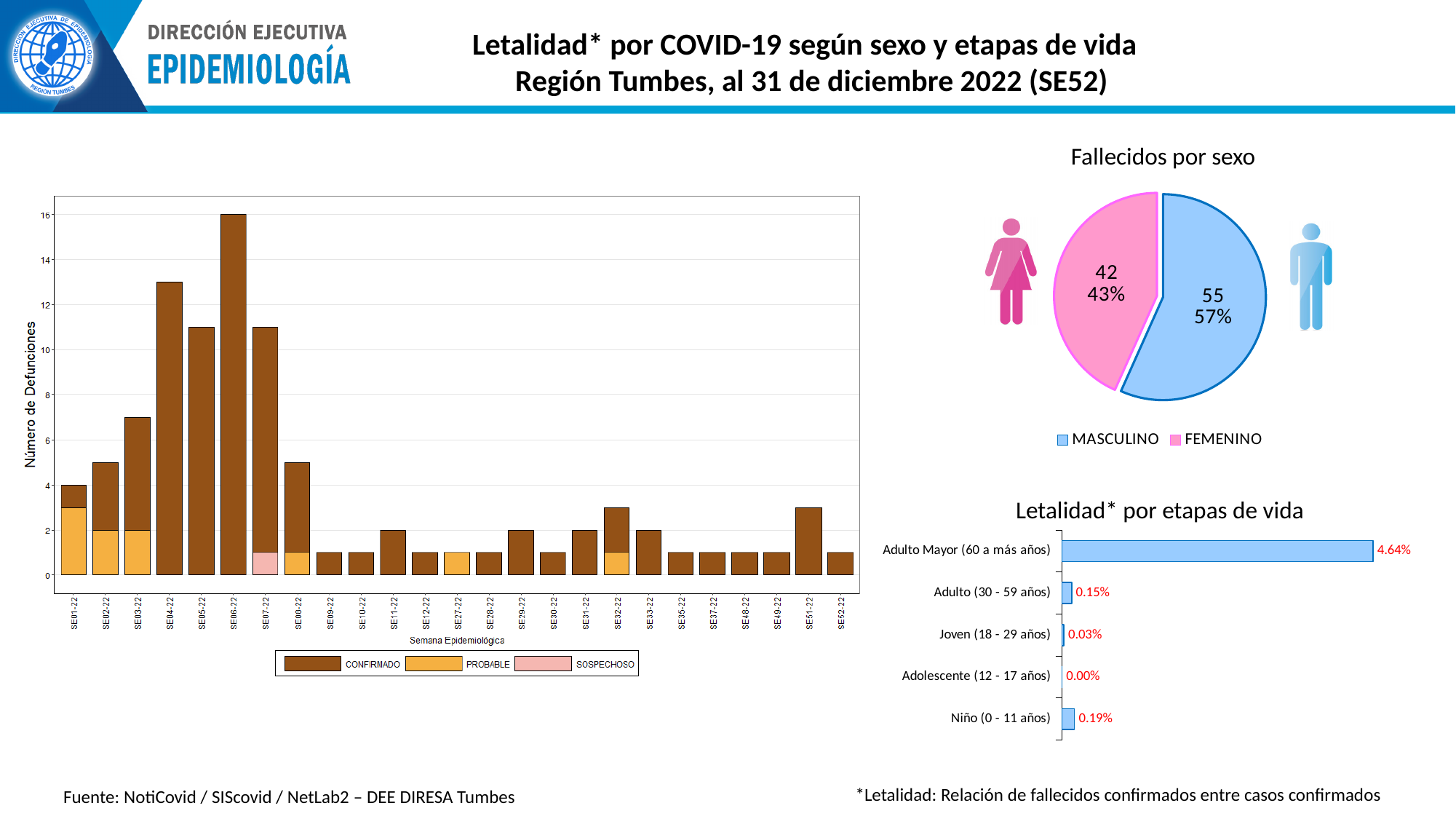
In the 'Letalidad* por etapas de vida' chart, what is the value for Adulto Mayor (60 a más años)? 4.64% How many series does the legend of the weekly 'Número de Defunciones' bar chart list? 3 In the 'Fallecidos por sexo' pie chart, which group has the larger slice, MASCULINO or FEMENINO? MASCULINO In the 'Fallecidos por sexo' pie chart, how many deaths are MASCULINO? 55 In the 'Letalidad* por etapas de vida' chart, which is larger, the value for Adulto (30 - 59 años) or Niño (0 - 11 años)? Niño (0 - 11 años) In the weekly 'Número de Defunciones' bar chart, is the total for SE04-22 greater or less than 12? greater In the 'Letalidad* por etapas de vida' chart, what is the value for Niño (0 - 11 años)? 0.19% In the 'Fallecidos por sexo' pie chart, what is the difference between the MASCULINO and FEMENINO counts? 13 In the 'Fallecidos por sexo' pie chart, what share of deaths is FEMENINO? 43% In the 'Letalidad* por etapas de vida' chart, how many age groups are shown? 5 In the 'Letalidad* por etapas de vida' chart, which age group has the lowest value? Adolescente (12 - 17 años) In the weekly 'Número de Defunciones' bar chart, which epidemiological week has the highest bar? SE06-22